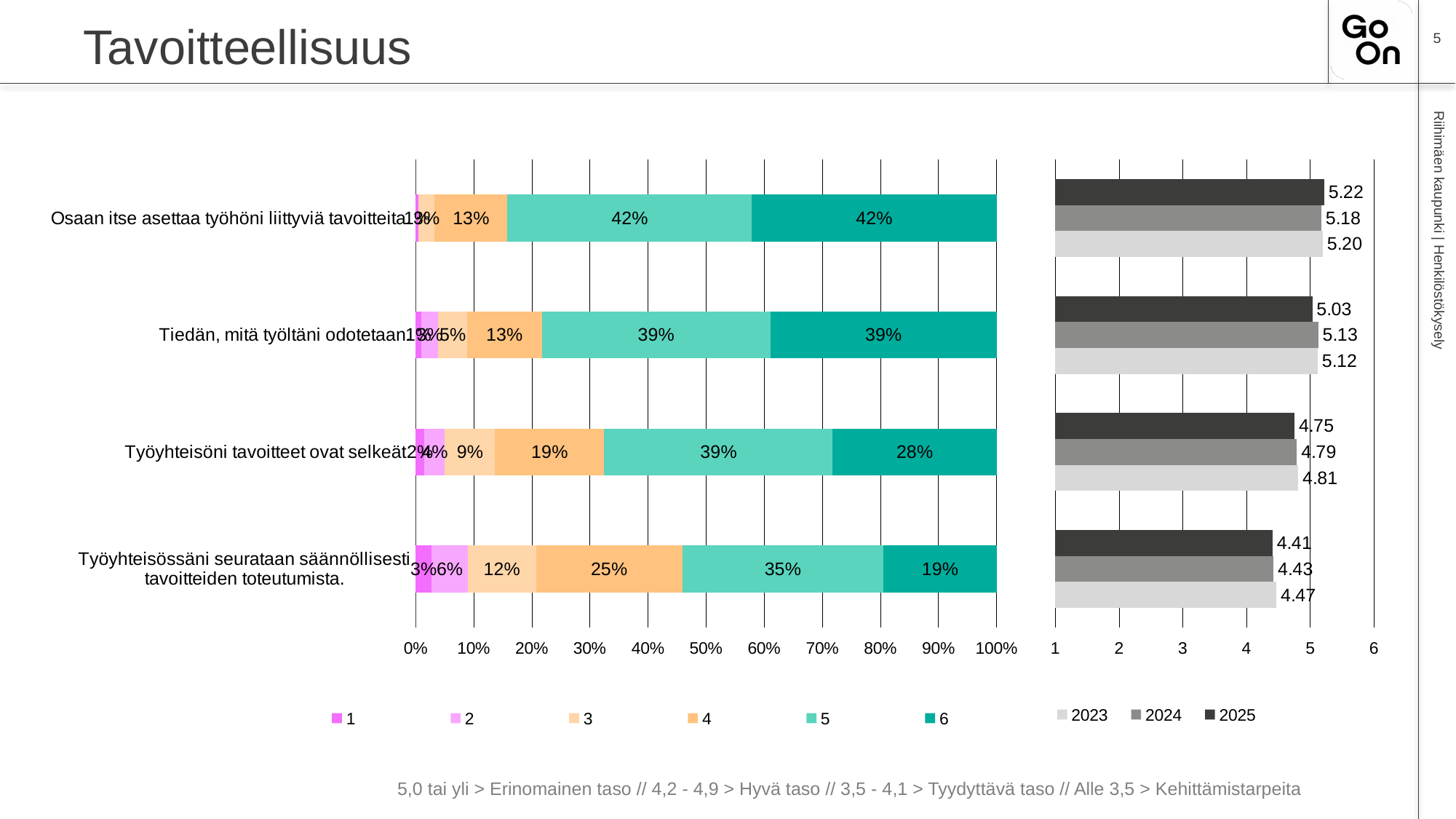
In the right-hand chart, which statement has the highest 2025 value? Osaan itse asettaa työhöni liittyviä tavoitteita In the right-hand chart, what is the difference between the 2023 and 2025 values for "Työyhteisössäni seurataan säännöllisesti tavoitteiden toteutumista."? 0.06 In the left-hand stacked bar chart, what percentage of responses for "Työyhteisössäni seurataan säännöllisesti tavoitteiden toteutumista." are in category 6? 19% What type of chart is the left-hand chart? Stacked bar chart In the left-hand stacked bar chart, what percentage of responses for "Työyhteisössäni seurataan säännöllisesti tavoitteiden toteutumista." are in category 4? 25% In the right-hand chart, for "Tiedän, mitä työltäni odotetaan", which year has the larger value: 2024 or 2025? 2024 In the right-hand chart, what is the 2025 value for "Osaan itse asettaa työhöni liittyviä tavoitteita"? 5.22 In the left-hand stacked bar chart, what percentage of responses for "Työyhteisöni tavoitteet ovat selkeät" are in category 5? 39% How many statements (categories) are shown in the left-hand stacked bar chart? 4 How many series does the legend of the right-hand chart list? 3 In the left-hand stacked bar chart, what is the combined percentage of categories 5 and 6 for "Osaan itse asettaa työhöni liittyviä tavoitteita"? 84% In the right-hand chart, which statement has the lowest 2023 value? Työyhteisössäni seurataan säännöllisesti tavoitteiden toteutumista.